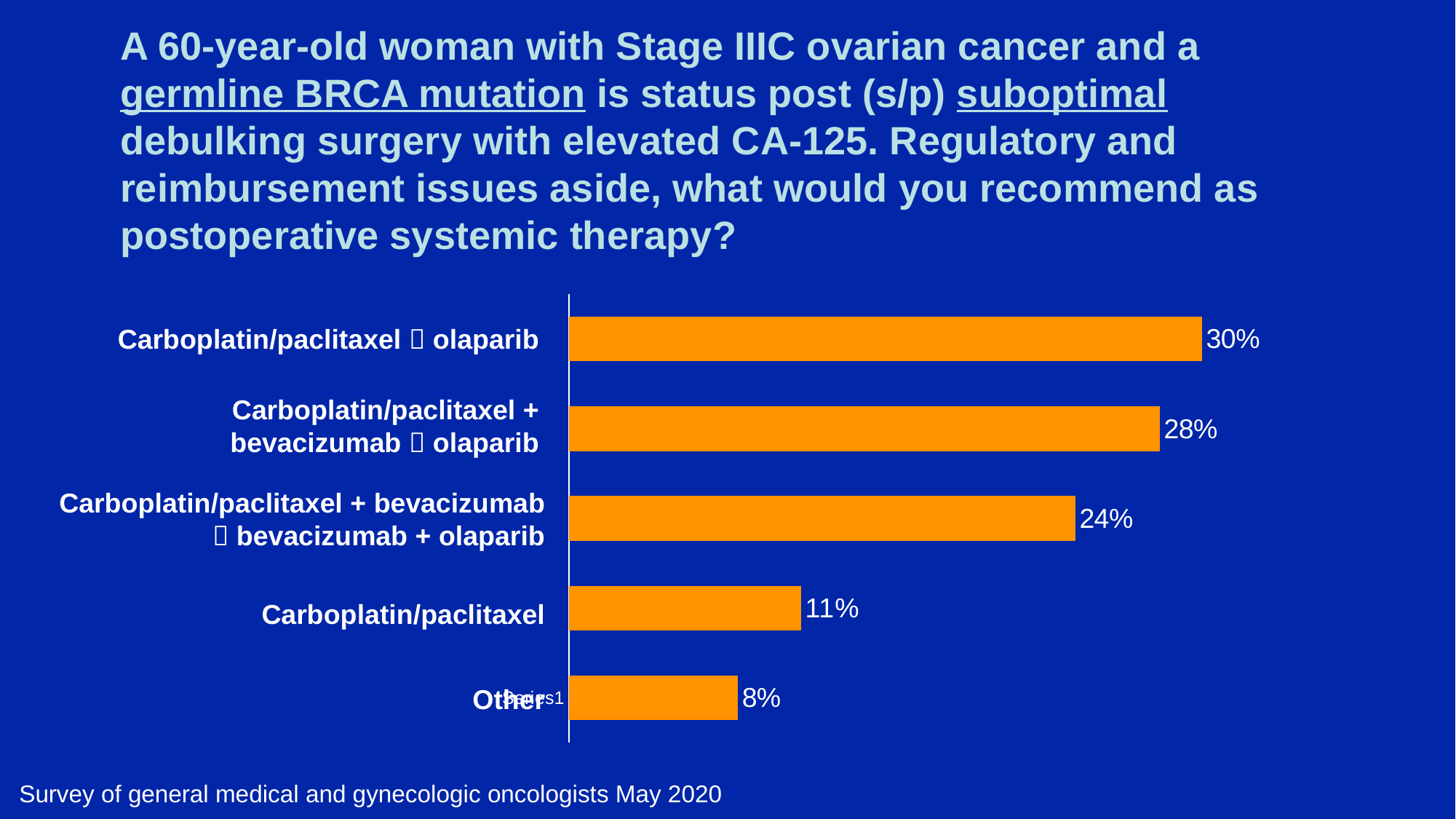
What percentage of respondents chose 'Other'? 8% What colour are the bars in the chart? Orange What percentage of respondents recommended carboplatin/paclitaxel + bevacizumab followed by bevacizumab + olaparib? 24% Which option received the lowest percentage of recommendations? Other How many response options are shown in the chart? 5 What is the difference in percentage points between carboplatin/paclitaxel → olaparib and carboplatin/paclitaxel alone? 19 percentage points What percentage of respondents recommended carboplatin/paclitaxel alone? 11% Which received a larger share: carboplatin/paclitaxel + bevacizumab → bevacizumab + olaparib, or carboplatin/paclitaxel alone? Carboplatin/paclitaxel + bevacizumab → bevacizumab + olaparib What percentage of respondents recommended carboplatin/paclitaxel followed by olaparib? 30% Which option received the highest percentage of recommendations? Carboplatin/paclitaxel → olaparib What type of chart is shown on the slide? Bar chart What percentage of respondents recommended carboplatin/paclitaxel + bevacizumab followed by olaparib? 28%